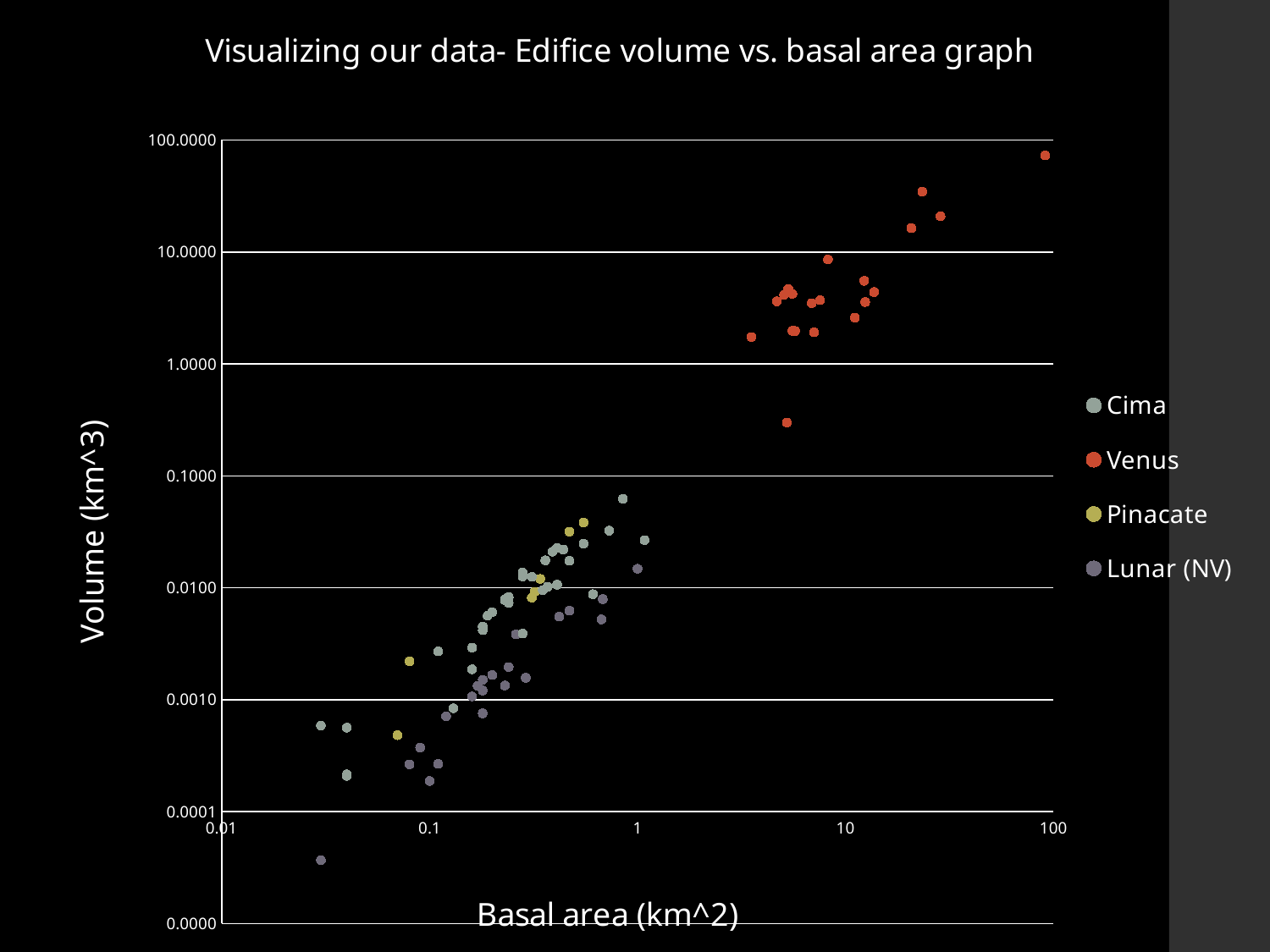
What kind of chart is shown on the slide? scatter chart Is the volume of the highest Cima point greater or less than 0.1? less Which series has larger volumes overall, Venus or Cima? Venus Is the volume of the highest Venus point greater or less than 10? greater What is the title of the chart? Visualizing our data- Edifice volume vs. basal area graph Which series has larger basal areas overall, Venus or Pinacate? Venus What is the label of the vertical axis? Volume (km^3) How many series does the legend list? 4 Is the basal area of the largest Venus point greater or less than 10? greater As basal area increases along the x axis, does volume generally rise or fall? rise Which series contains the point with the lowest volume? Lunar (NV) Which series contains the point with the highest volume? Venus